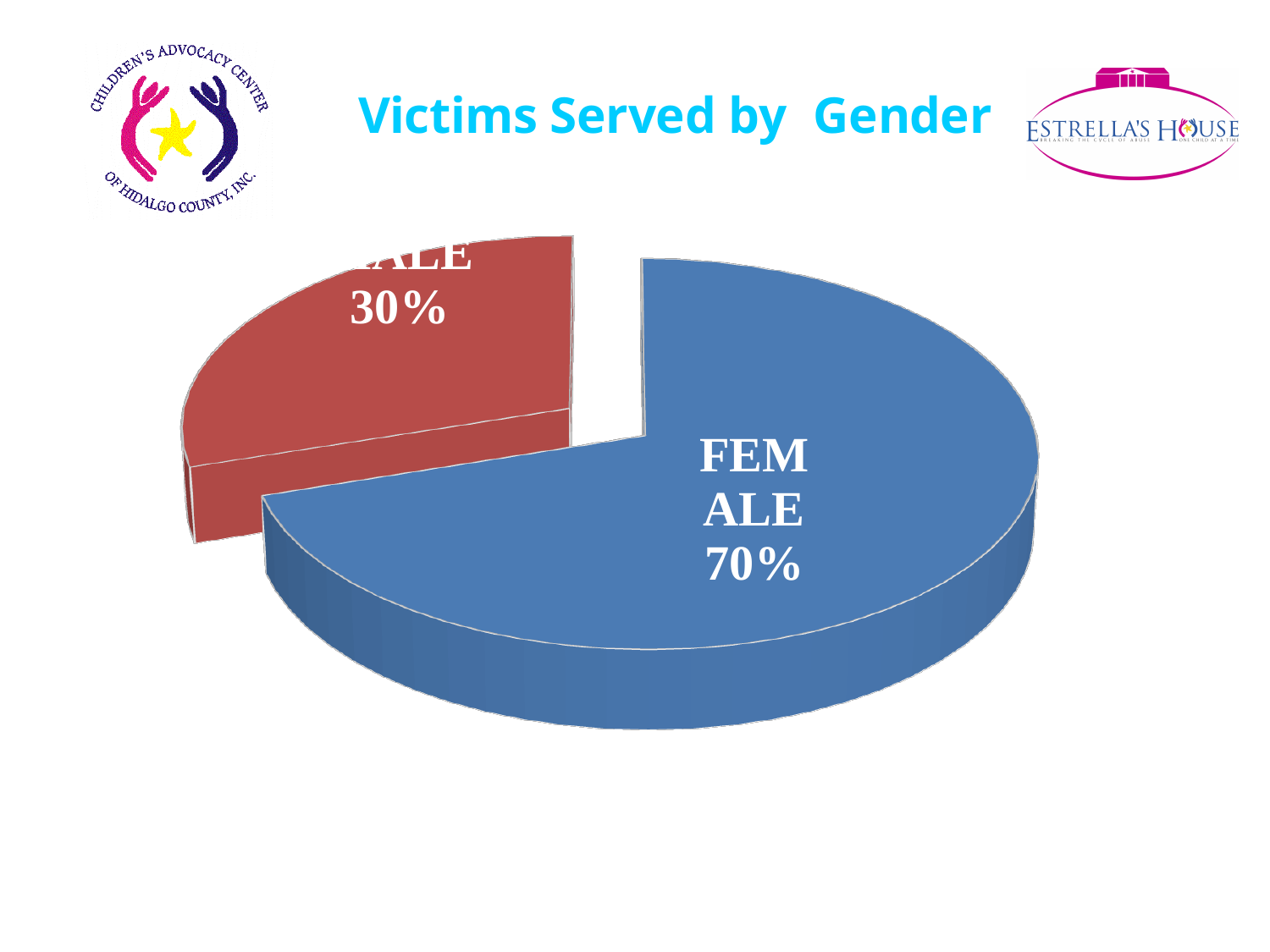
What is the title of the chart? Victims Served by Gender What colour is the FEMALE slice of the pie chart? blue What percentage of victims served were female? 70% What kind of chart is shown on the slide? pie chart What is the difference in percentage points between the FEMALE slice and the red slice? 40 Which slice of the pie chart is the largest? FEMALE Which is larger, the FEMALE slice or the red slice? FEMALE How many slices does the pie chart have? 2 What share of the pie does the FEMALE slice represent? 70% What percentage is shown on the red slice of the pie chart? 30%